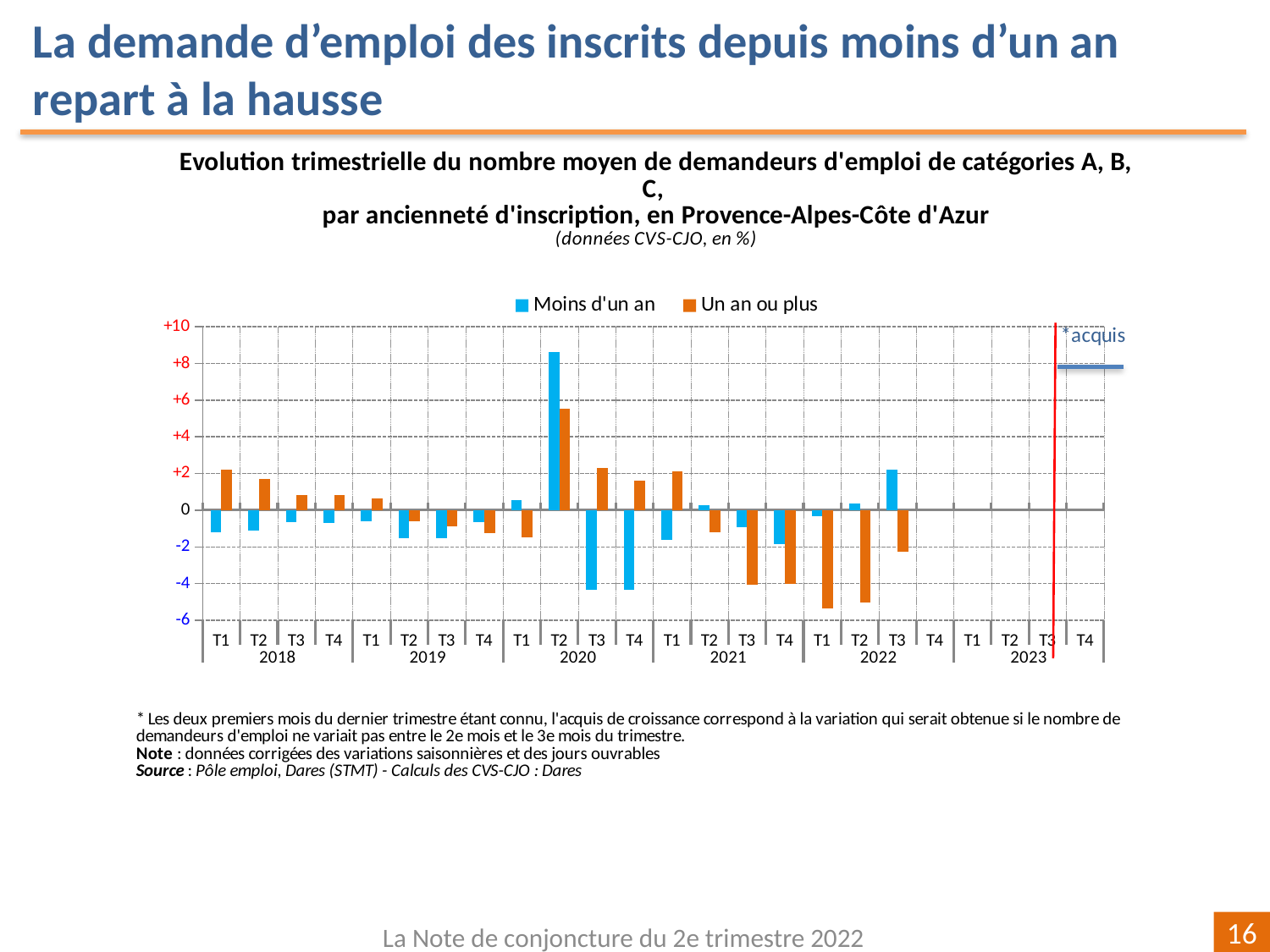
Is the value for 'Moins d'un an' in T2 2020 greater or less than +8? greater In which quarter does the 'Moins d'un an' series reach its highest value? T2 2020 How many years are labelled along the x axis? 6 Is the value for 'Un an ou plus' in T1 2022 greater or less than -4? less In T2 2020, which series has the larger value, 'Moins d'un an' or 'Un an ou plus'? Moins d'un an What type of chart is shown on the slide? Bar chart How many series does the legend list? 2 Is the value for 'Un an ou plus' in T2 2020 greater or less than +4? greater In T3 2022, which series has the larger value, 'Moins d'un an' or 'Un an ou plus'? Moins d'un an What are the two series named in the legend? Moins d'un an and Un an ou plus Does the 'Un an ou plus' series rise or fall from T1 2018 to T3 2018? Fall